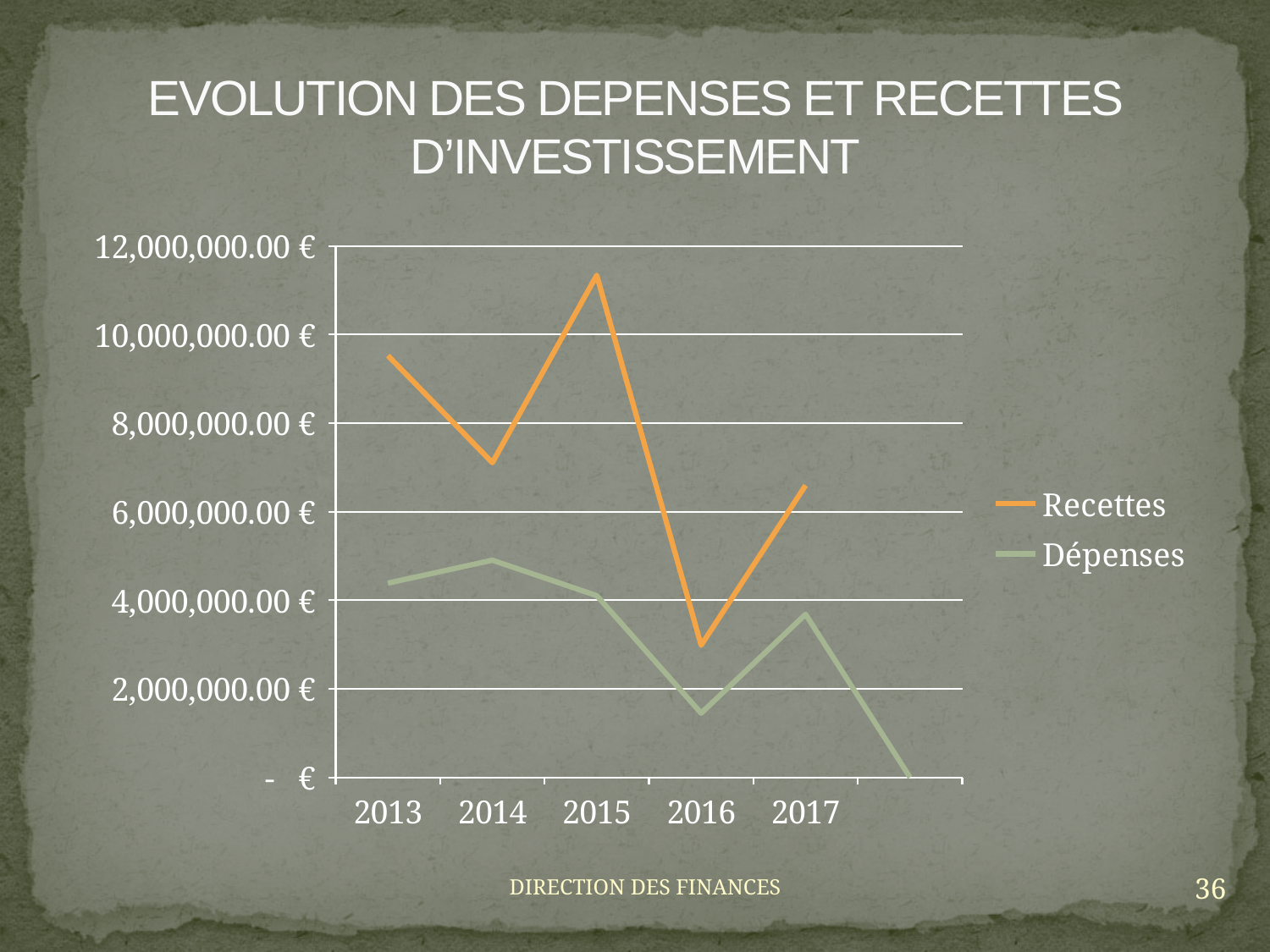
In 2015, which series has the larger value, Recettes or Dépenses? Recettes What kind of chart is shown on the slide? line chart In which year is the Recettes value highest? 2015 In which of the labelled years is the Dépenses value highest? 2014 Is the Dépenses value for 2014 greater or less than 6,000,000.00 €? less Do the Recettes values rise or fall from 2015 to 2016? fall In which year is the Recettes value lowest? 2016 What colour is the Recettes line? orange Is the Recettes value for 2016 greater or less than 4,000,000.00 €? less Is the Recettes value for 2013 greater or less than 8,000,000.00 €? greater How many series does the legend list? 2 In which of the labelled years is the Dépenses value lowest? 2016